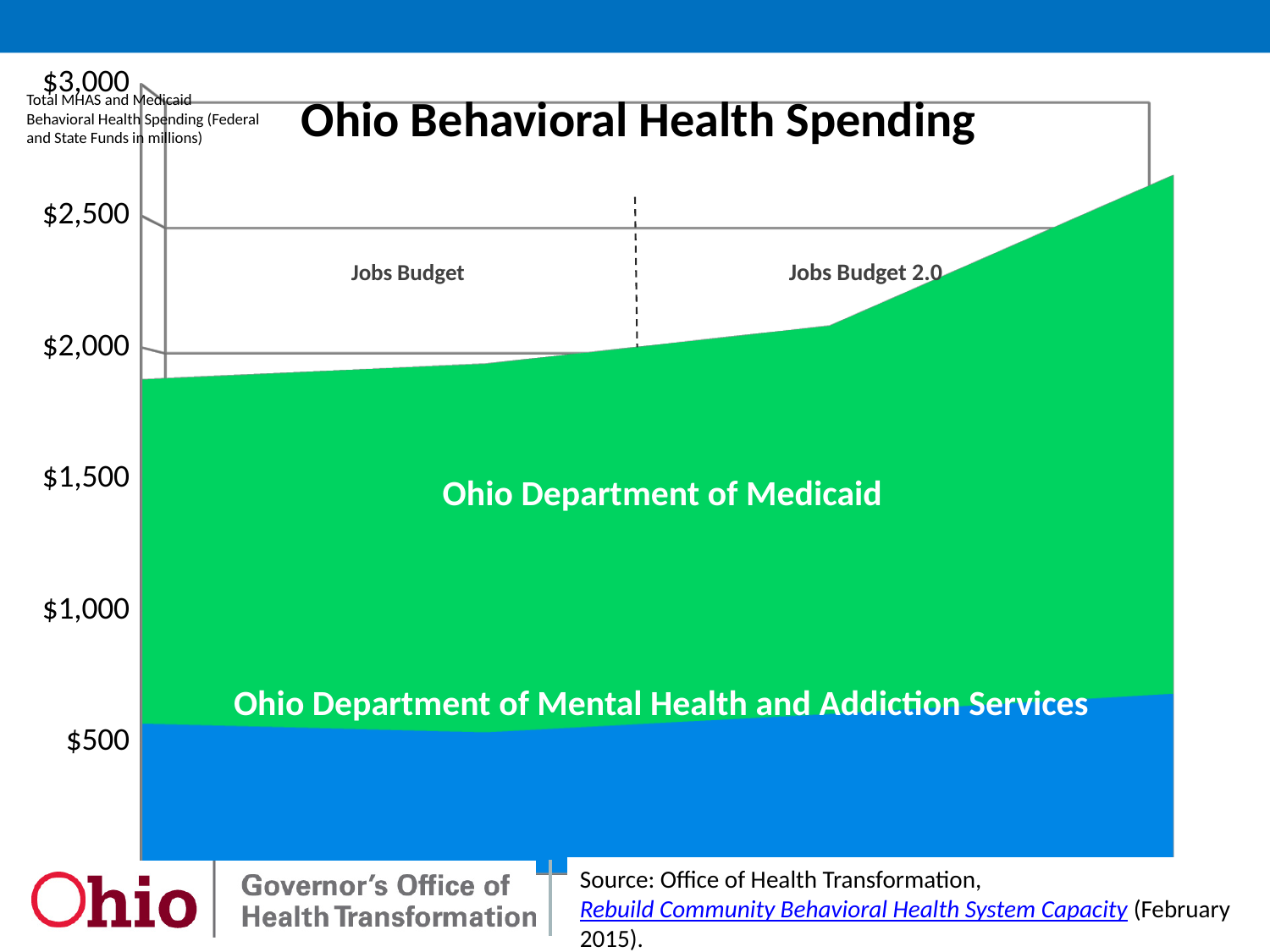
What are the two budget periods labeled on the chart? Jobs Budget and Jobs Budget 2.0 Is the total spending at the right end of the chart greater or less than $2,500? greater Does total behavioral health spending rise or fall from left to right across the chart? Rise Which colour represents the Ohio Department of Medicaid series? Green What is the highest value shown on the vertical axis? $3,000 What kind of chart is shown on the slide? Stacked area chart Is the total spending at the left end of the chart greater or less than $2,000? less How many spending series are stacked in the chart? 2 Which series occupies the larger area of the chart, Ohio Department of Medicaid or Ohio Department of Mental Health and Addiction Services? Ohio Department of Medicaid Is the total spending at the left end of the chart greater or less than $1,500? greater